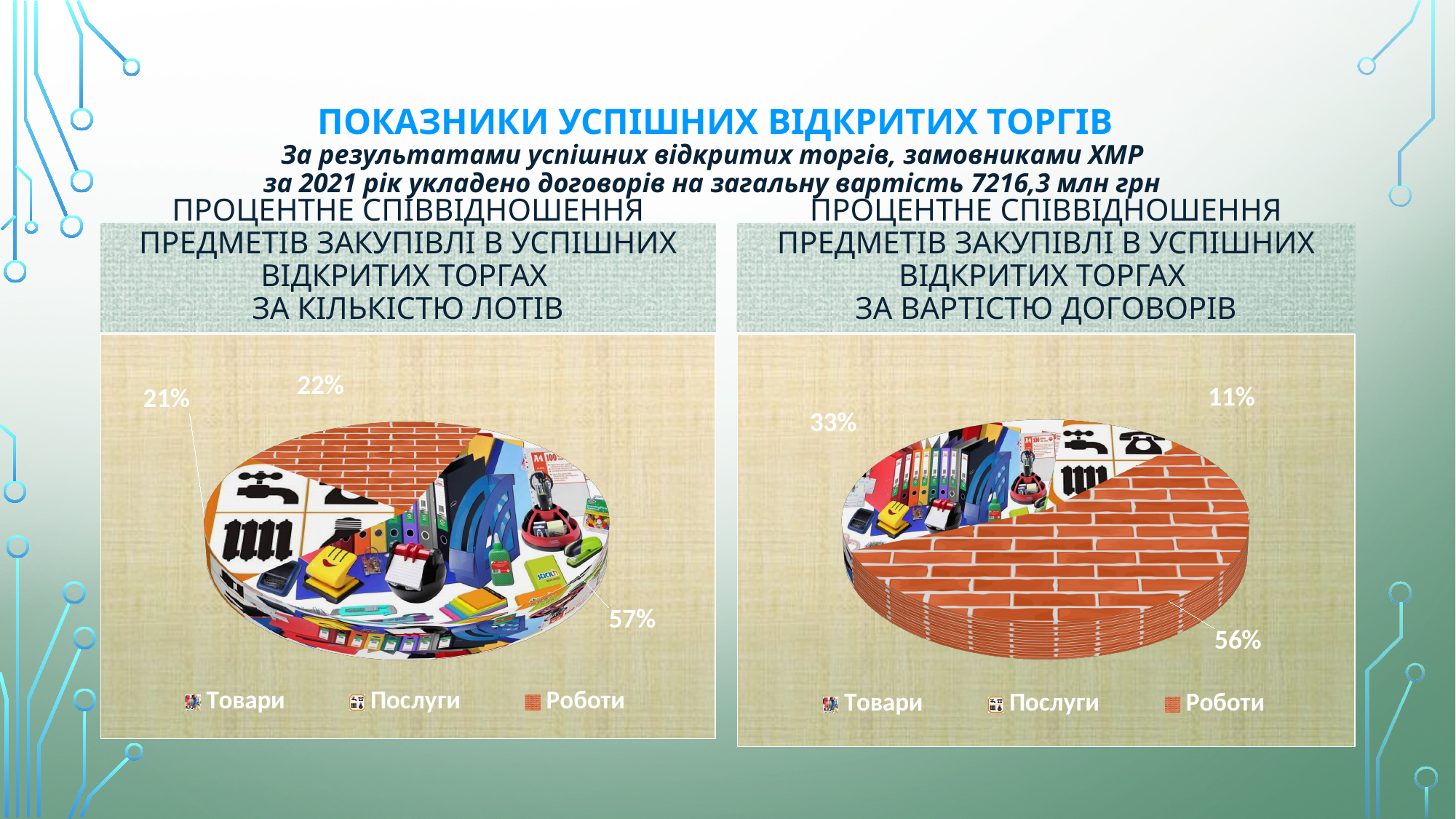
In the left pie chart (за кількістю лотів), what share is labelled for Роботи? 22% In the right pie chart (за вартістю договорів), what share is labelled for Послуги? 11% What kind of chart is shown on the left side of the slide (за кількістю лотів)? pie chart In the left pie chart (за кількістю лотів), which category has the largest share? Товари In the right pie chart (за вартістю договорів), which is larger: the share of Товари or the share of Послуги? Товари In the left pie chart (за кількістю лотів), what share is labelled for Товари? 57% In the left pie chart (за кількістю лотів), what share is labelled for Послуги? 21% In the right pie chart (за вартістю договорів), what share is labelled for Роботи? 56% In the right pie chart (за вартістю договорів), what is the difference between the shares of Роботи and Товари? 23% In the right pie chart (за вартістю договорів), what share is labelled for Товари? 33% How many categories does the legend of the left pie chart list? 3 In the right pie chart (за вартістю договорів), which category has the smallest share? Послуги